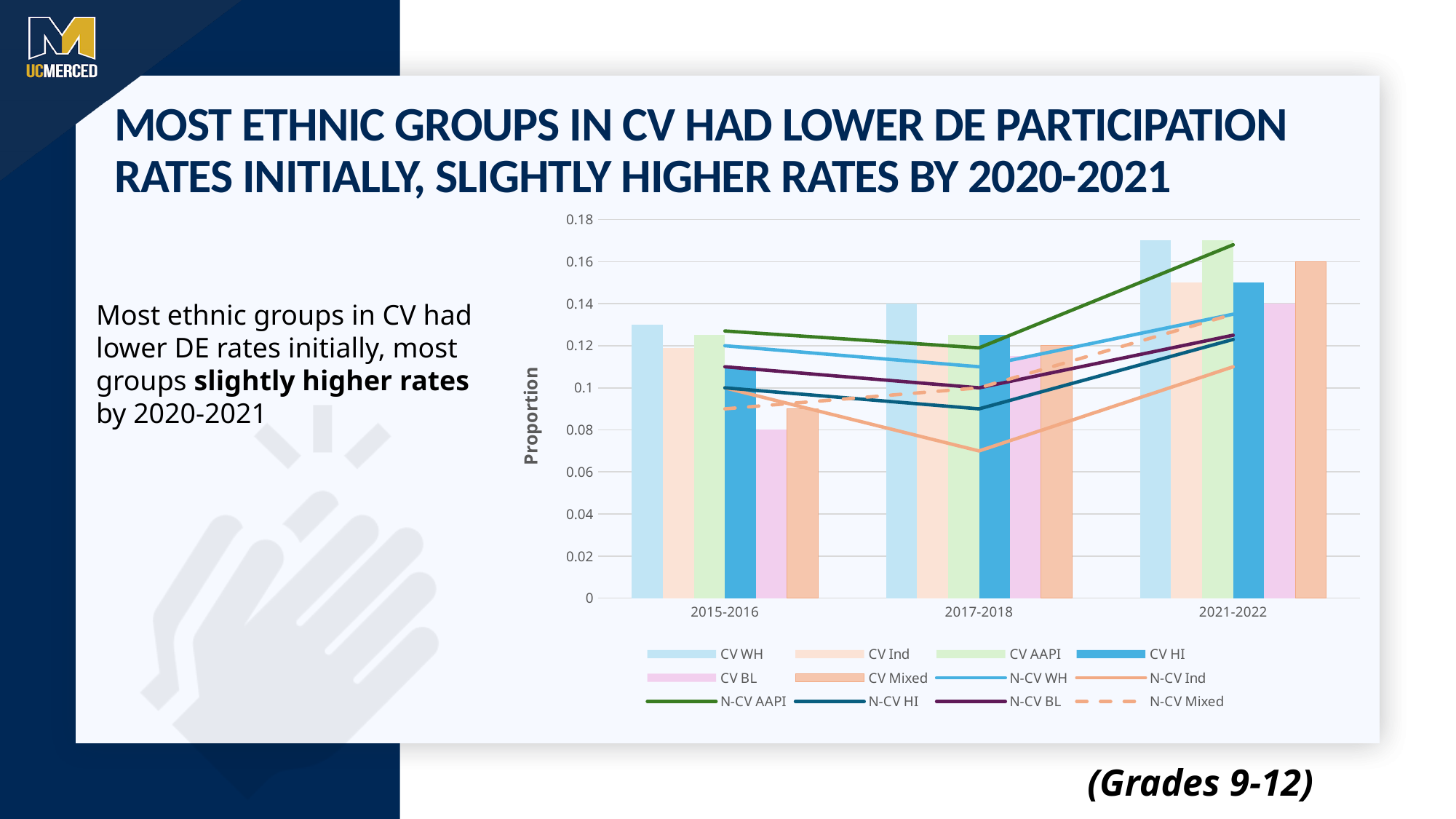
In 2015-2016, which bar is larger: CV WH or CV BL? CV WH Is the N-CV Ind line value for 2017-2018 greater or less than 0.08? less What is the value of the CV WH bar for 2017-2018? 0.14 How many year categories are shown on the x axis? 3 How many series does the chart legend list? 12 Is the value of the CV WH bar for 2021-2022 greater or less than 0.16? greater What is the value of the CV Mixed bar for 2021-2022? 0.16 What is the value of the CV BL bar for 2015-2016? 0.08 What kind of chart is shown on the slide? A combined bar and line chart Which CV group has the lowest bar in 2015-2016? CV BL What is the label of the y axis? Proportion Do the CV BL bars rise or fall from 2015-2016 to 2021-2022? Rise